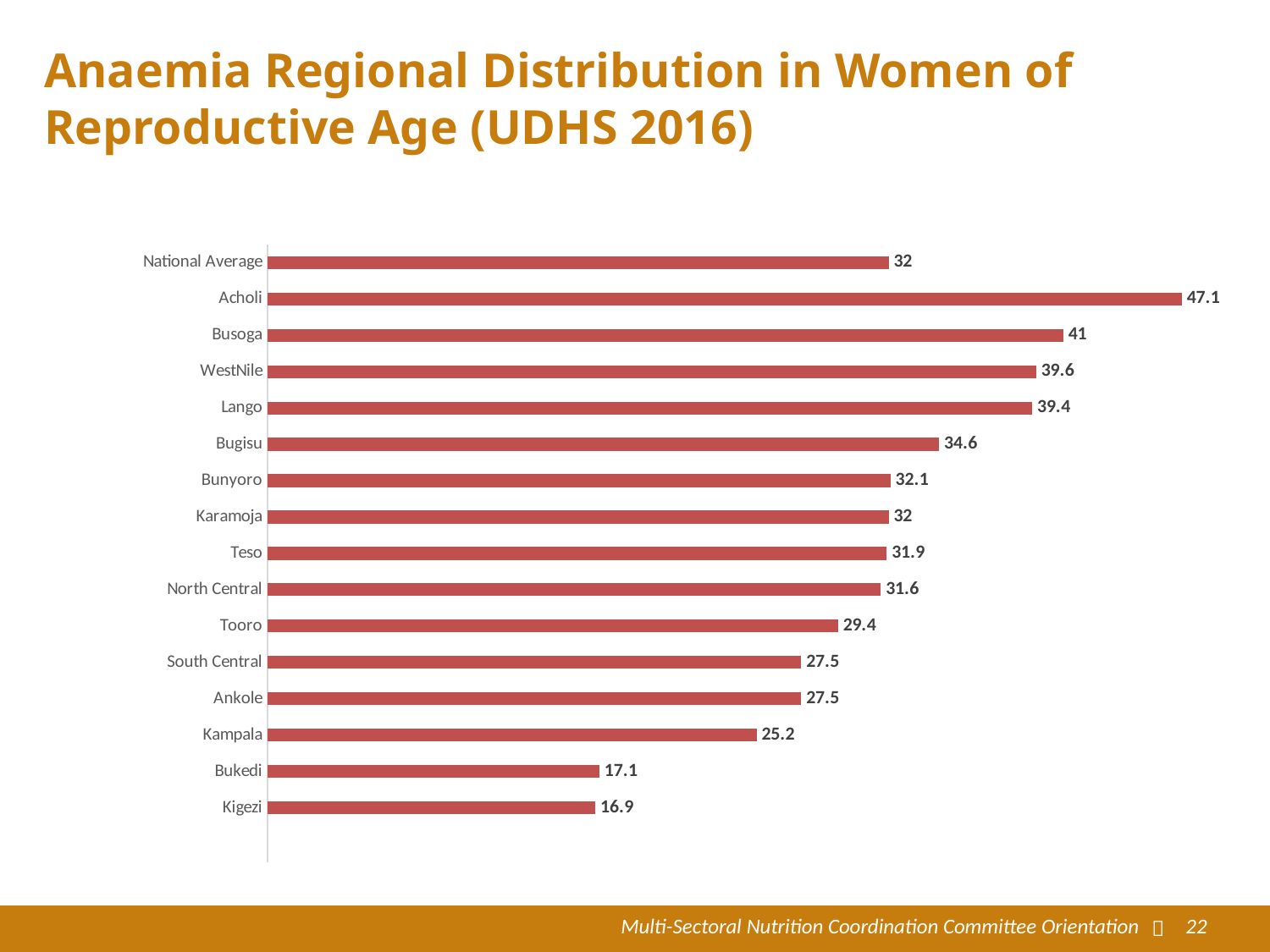
What is the value for Kampala? 25.2 What is the difference between the values for Acholi and Busoga? 6.1 What kind of chart is shown on the slide? Bar chart Which has a larger value, WestNile or Lango? WestNile Which region has the highest value? Acholi What is the difference between the values for Bukedi and Kigezi? 0.2 What is the value for Acholi? 47.1 What is the value for Bunyoro? 32.1 Which region has the lowest value? Kigezi What is the National Average value shown on the chart? 32 How many bars are plotted on the chart? 16 Which has a larger value, Bugisu or Tooro? Bugisu